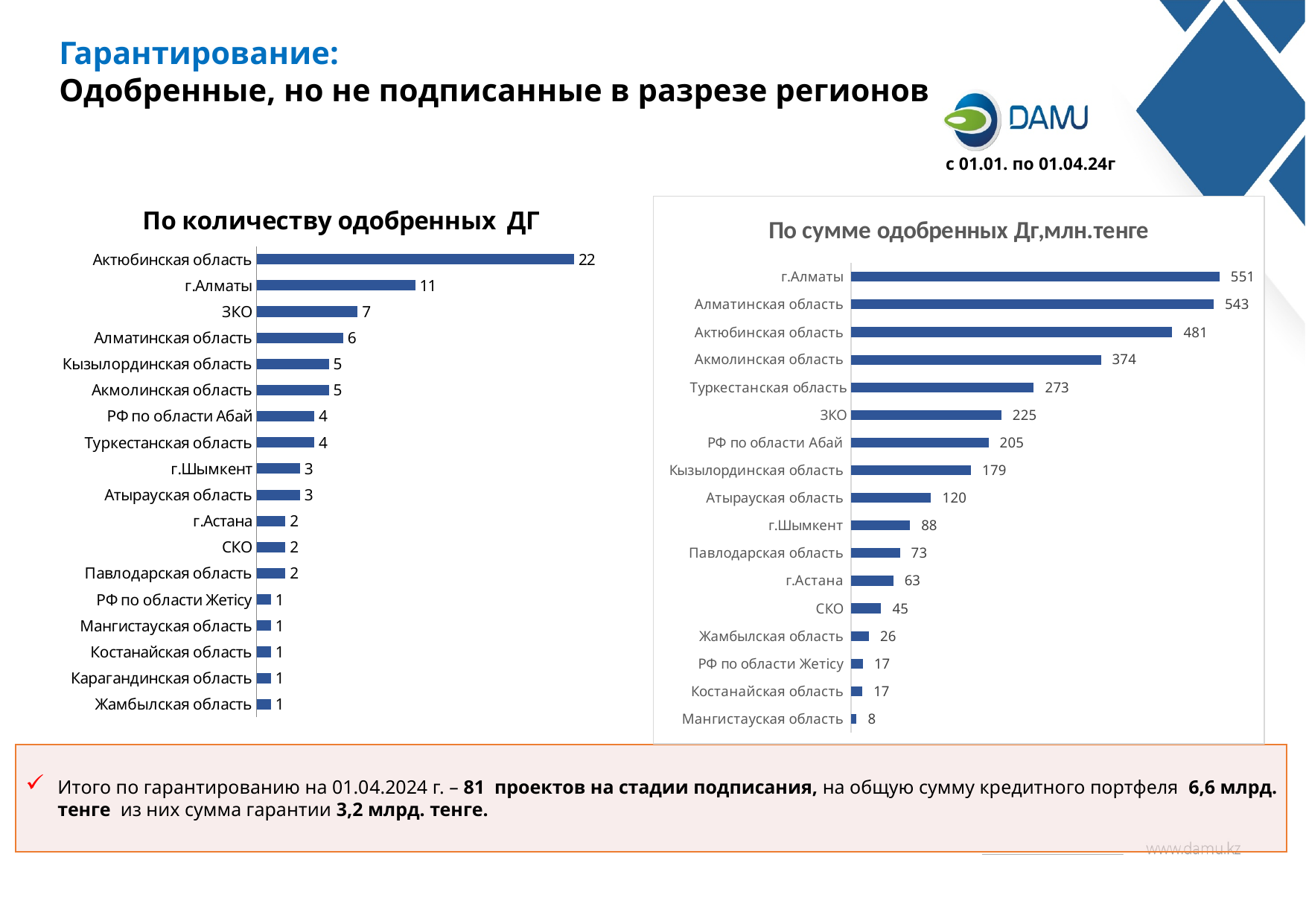
In the chart 'По количеству одобренных ДГ', what is the value for Актюбинская область? 22 In the chart 'По сумме одобренных Дг,млн.тенге', what is the value for Акмолинская область? 374 In the chart 'По количеству одобренных ДГ', what is the difference between г.Алматы and ЗКО? 4 In the chart 'По сумме одобренных Дг,млн.тенге', how many regions are shown? 17 In the chart 'По сумме одобренных Дг,млн.тенге', which region has the lowest value? Мангистауская область In the chart 'По количеству одобренных ДГ', which region has the highest value? Актюбинская область What is the title of the chart on the left side of the slide? По количеству одобренных ДГ In the chart 'По сумме одобренных Дг,млн.тенге', which is larger: Туркестанская область or ЗКО? Туркестанская область In the chart 'По количеству одобренных ДГ', how many regions are shown? 18 In the chart 'По сумме одобренных Дг,млн.тенге', what is the value for СКО? 45 What type of chart is 'По сумме одобренных Дг,млн.тенге'? Bar chart In the chart 'По сумме одобренных Дг,млн.тенге', what is the difference between г.Алматы and Алматинская область? 8